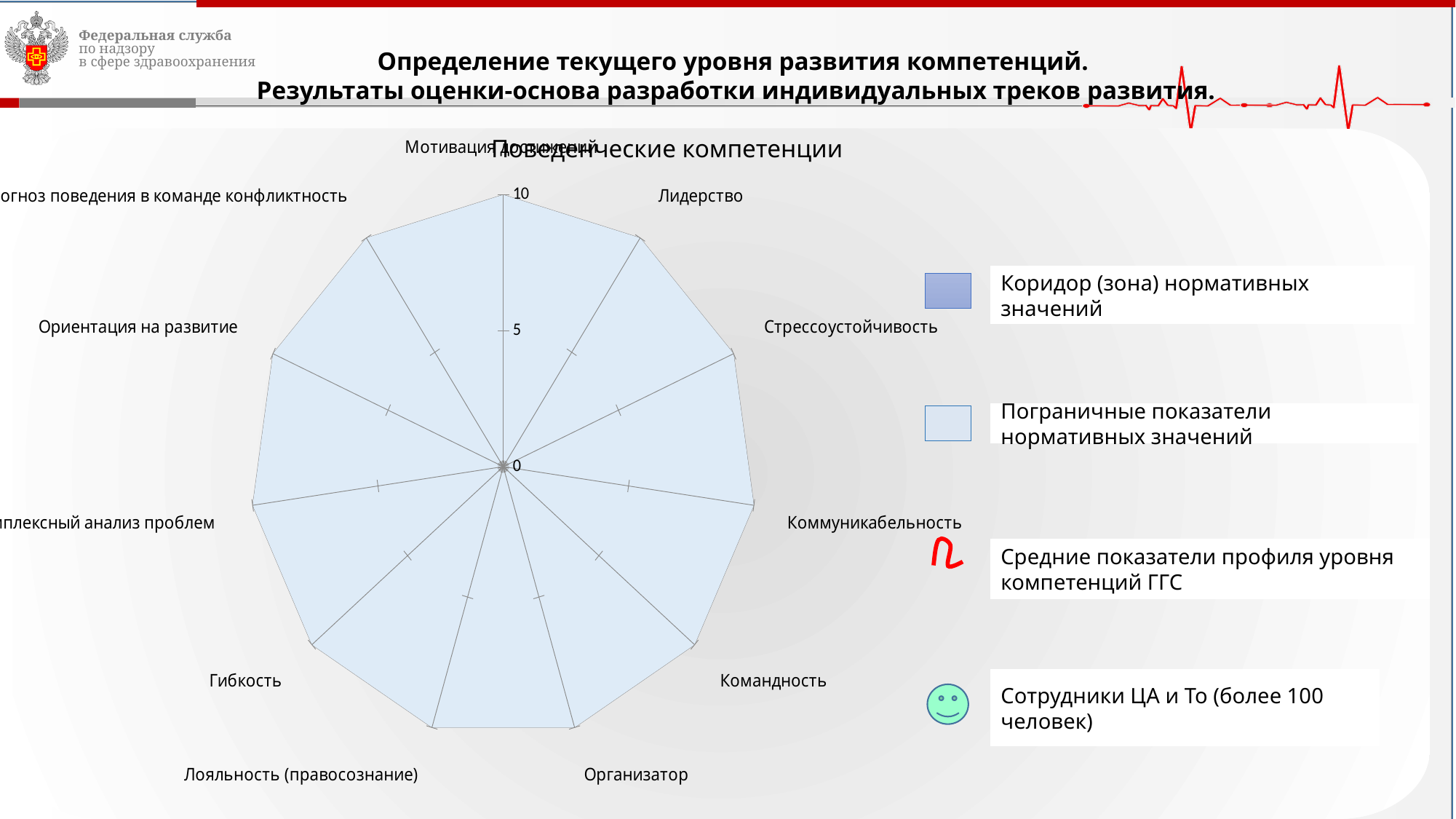
How many competency axes (categories) does the radar chart have? 11 What is the title of the chart? Поведенческие компетенции Is the value for Стрессоустойчивость greater or less than 5? greater What kind of chart is shown on the slide? radar chart Is the value for Командность greater or less than 5? greater Is the value for Организатор greater or less than 5? greater What is the maximum value shown on the chart's axis scale? 10